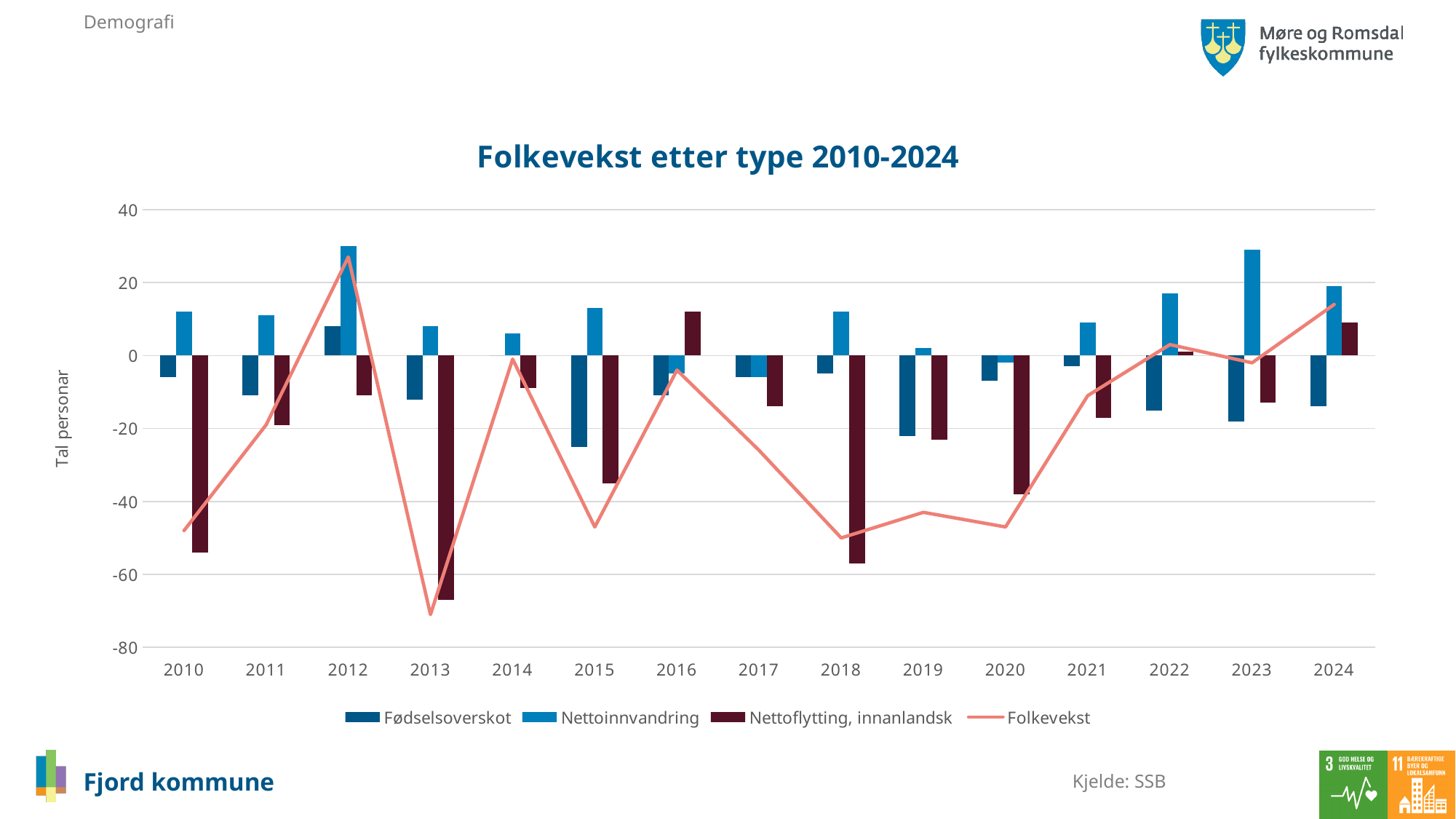
What is the title of the chart? Folkevekst etter type 2010-2024 How many series does the legend list? 4 In which year does the Folkevekst line reach its lowest point? 2013 Is the Nettoinnvandring value for 2012 greater or less than 20? greater Does the Folkevekst line rise or fall from 2018 to 2024? rise Is the Nettoflytting, innanlandsk value for 2013 greater or less than -60? less Which is larger, the Nettoinnvandring value for 2023 or for 2019? 2023 What kind of chart is shown on the slide? Combined bar and line chart In which year is the Fødselsoverskot bar highest? 2012 In which year does the Folkevekst line reach its highest point? 2012 In which year is the Nettoflytting, innanlandsk bar lowest? 2013 How many years are shown on the x axis? 15